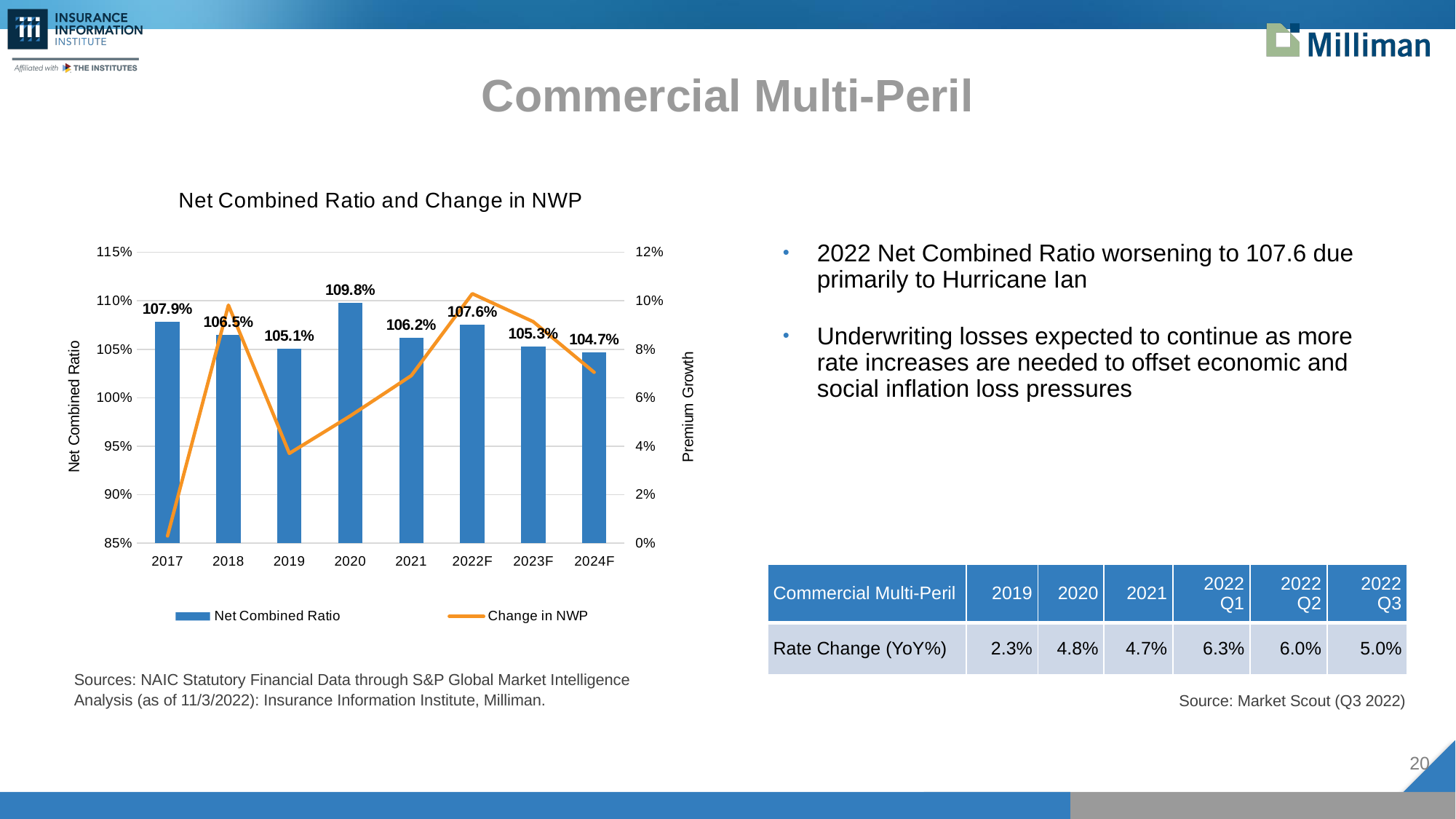
What is the difference between the Net Combined Ratio in 2017 and in 2024F? 3.2 percentage points Is the Change in NWP value for 2017 greater or less than 2%? less Which is larger, the Net Combined Ratio for 2018 or for 2021? 2018 How many years are shown on the x axis of the chart? 8 Is the Change in NWP value for 2018 greater or less than 8%? greater Which year has the lowest Net Combined Ratio? 2024F What is the Net Combined Ratio for 2020? 109.8% Which year has the highest Net Combined Ratio? 2020 What kind of chart is shown on the slide? Combination bar and line chart What is the Net Combined Ratio for 2024F? 104.7% Does the Net Combined Ratio rise or fall from 2022F to 2024F? Fall How many series does the chart legend list? 2